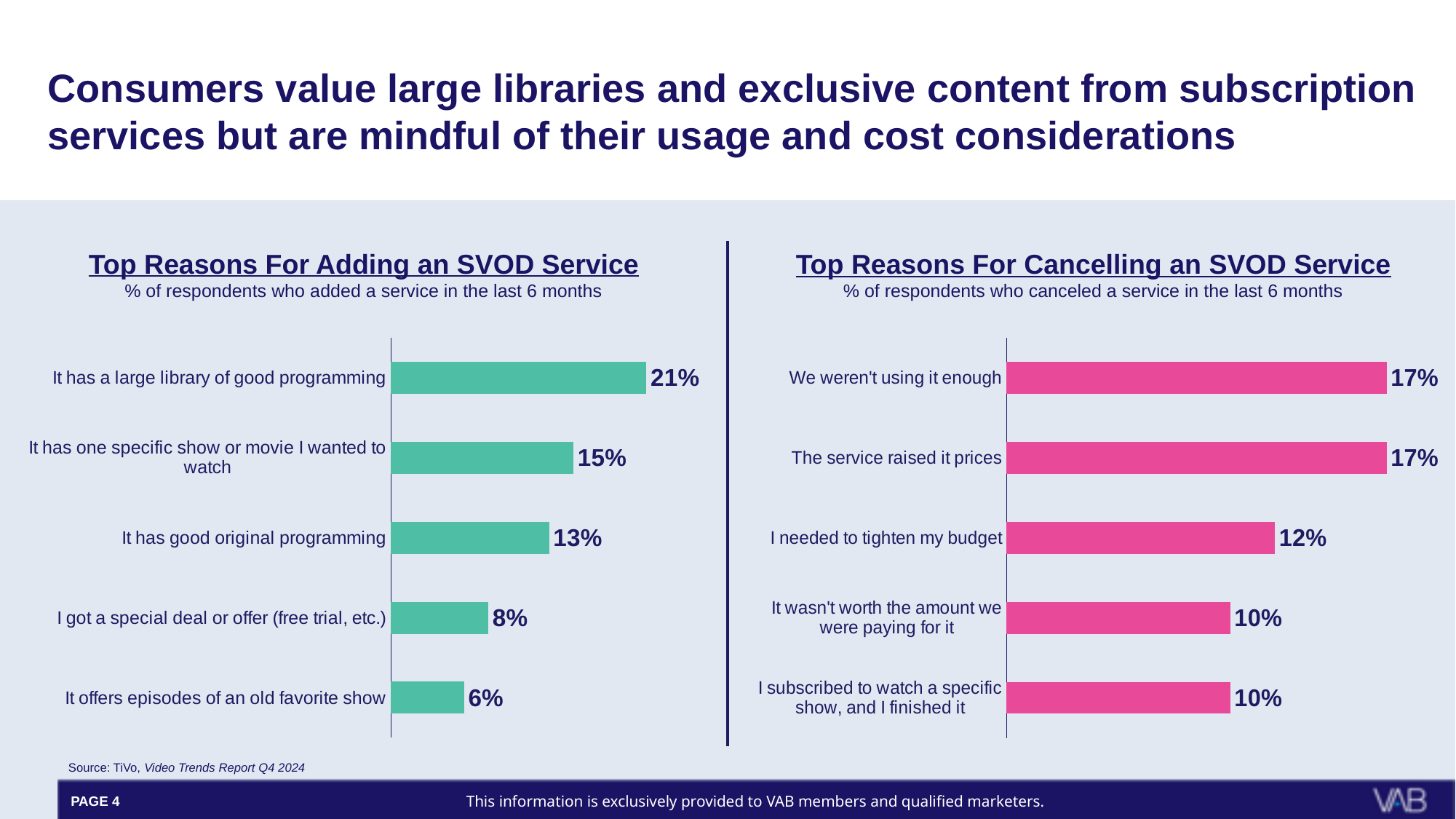
What type of chart is used for 'Top Reasons For Adding an SVOD Service'? Bar chart In the 'Top Reasons For Adding an SVOD Service' chart, which reason has the lowest percentage? It offers episodes of an old favorite show How many reasons are shown in the 'Top Reasons For Cancelling an SVOD Service' chart? 5 In the 'Top Reasons For Adding an SVOD Service' chart, what is the value for 'I got a special deal or offer (free trial, etc.)'? 8% In the 'Top Reasons For Cancelling an SVOD Service' chart, which reason has the lowest percentage, 'I needed to tighten my budget' or 'It wasn't worth the amount we were paying for it'? It wasn't worth the amount we were paying for it In the 'Top Reasons For Cancelling an SVOD Service' chart, what is the difference between 'We weren't using it enough' and 'I needed to tighten my budget'? 5% In the 'Top Reasons For Adding an SVOD Service' chart, what percentage of respondents said it has a large library of good programming? 21% What colour are the bars in the 'Top Reasons For Cancelling an SVOD Service' chart? Pink In the 'Top Reasons For Cancelling an SVOD Service' chart, what is the value for 'I needed to tighten my budget'? 12% In the 'Top Reasons For Cancelling an SVOD Service' chart, what value is shown for 'The service raised it prices'? 17% In the 'Top Reasons For Adding an SVOD Service' chart, what is the difference between 'It has a large library of good programming' and 'It has good original programming'? 8% In the 'Top Reasons For Adding an SVOD Service' chart, which reason has the highest percentage? It has a large library of good programming